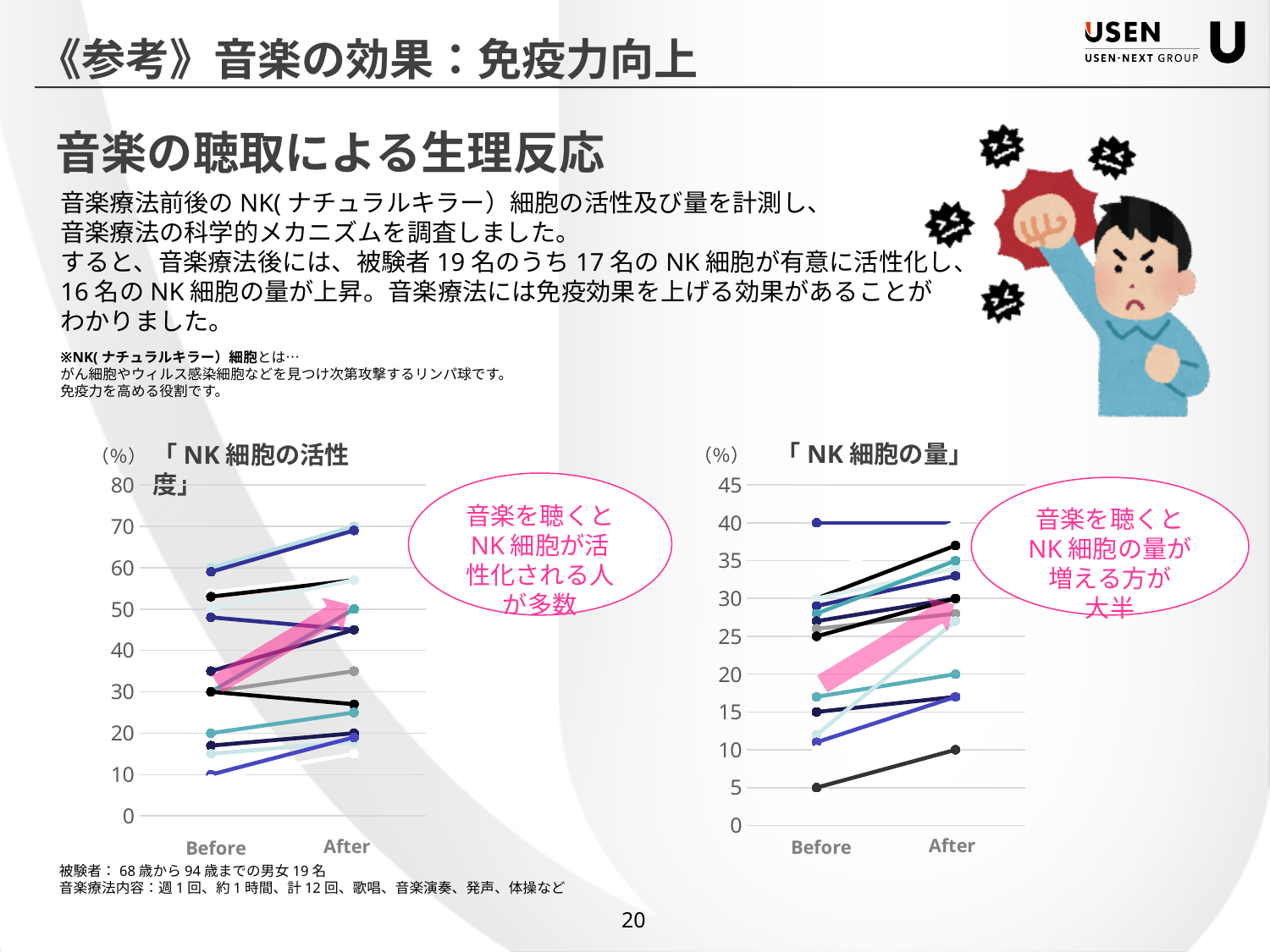
In the right chart 「NK細胞の量」, what is the highest value shown on the y axis? 45 In the right chart 「NK細胞の量」, is the highest Before value greater or less than 35? greater In the left chart 「NK細胞の活性度」, how many categories are shown on the x axis? 2 In the right chart 「NK細胞の量」, what are the two x-axis categories? Before, After In the left chart 「NK細胞の活性度」, do most of the lines rise or fall from Before to After? rise In the right chart 「NK細胞の量」, do most of the lines rise or fall from Before to After? rise In the left chart 「NK細胞の活性度」, is the lowest Before value greater or less than 20? less What kind of chart is the left chart titled 「NK細胞の活性度」? line chart What kind of chart is the right chart titled 「NK細胞の量」? line chart In the right chart 「NK細胞の量」, is the lowest Before value greater or less than 10? less In the left chart 「NK細胞の活性度」, what is the highest value shown on the y axis? 80